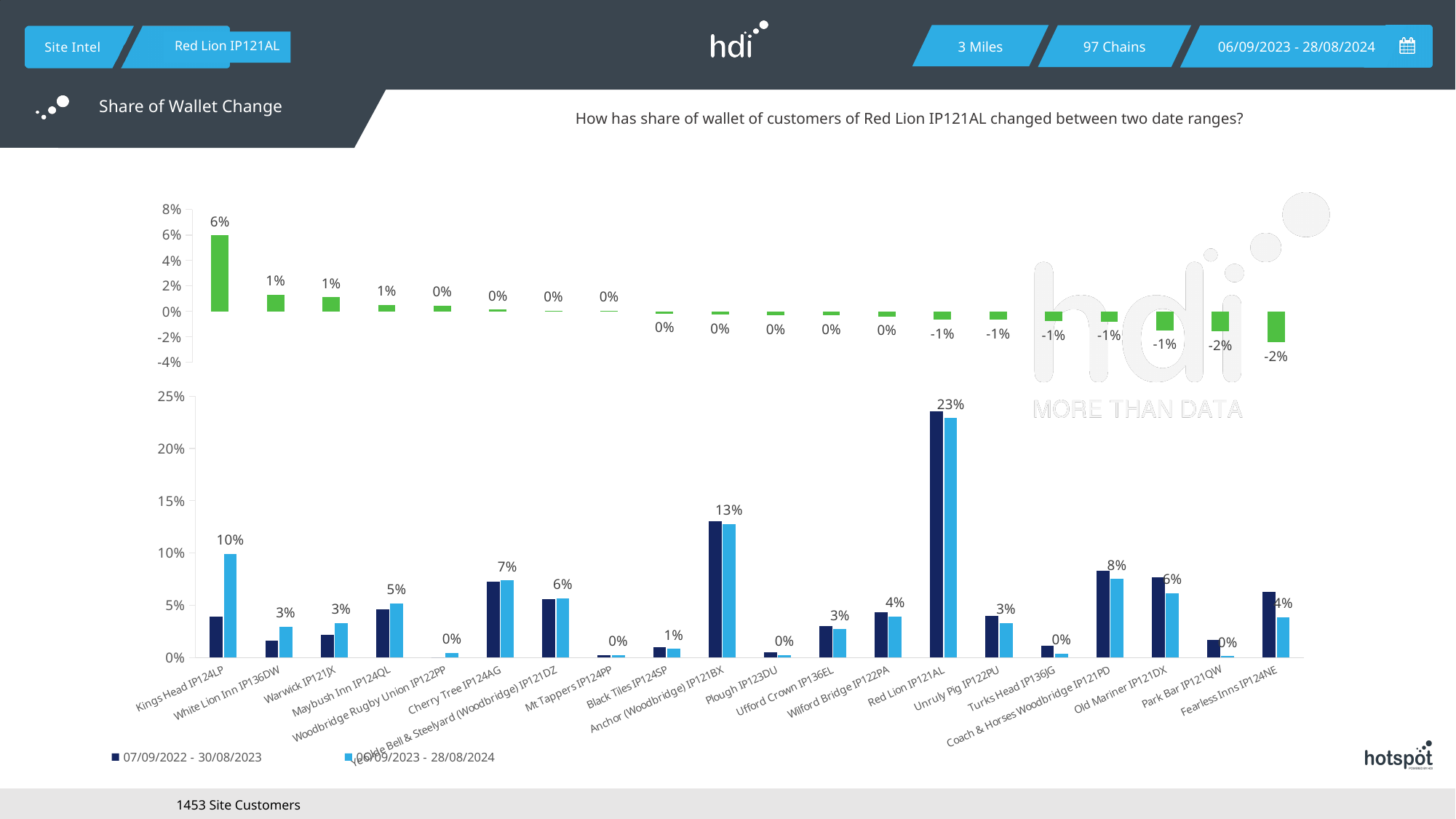
How many categories are shown on the x axis of the bottom chart? 20 In the bottom chart, for the 06/09/2023 - 28/08/2024 period, which is larger: Anchor (Woodbridge) IP121BX or Cherry Tree IP124AG? Anchor (Woodbridge) IP121BX In the bottom chart, what is the difference between the 06/09/2023 - 28/08/2024 values for Red Lion IP121AL and Anchor (Woodbridge) IP121BX? 10% In the bottom chart, is the 07/09/2022 - 30/08/2023 value for Kings Head IP124LP greater or less than 5%? less In the bottom chart, what is the share of wallet for Red Lion IP121AL in the 06/09/2023 - 28/08/2024 period? 23% What kind of chart is the bottom chart? Bar chart In the bottom chart, which category has the highest share of wallet? Red Lion IP121AL In the top chart, what is the share of wallet change for Fearless Inns IP124NE? -2% In the bottom chart, what is the share of wallet for Anchor (Woodbridge) IP121BX in the 06/09/2023 - 28/08/2024 period? 13% How many series does the legend of the bottom chart list? 2 In the top chart, which category shows the largest share of wallet change? Kings Head IP124LP In the top chart, what is the share of wallet change for Kings Head IP124LP? 6%